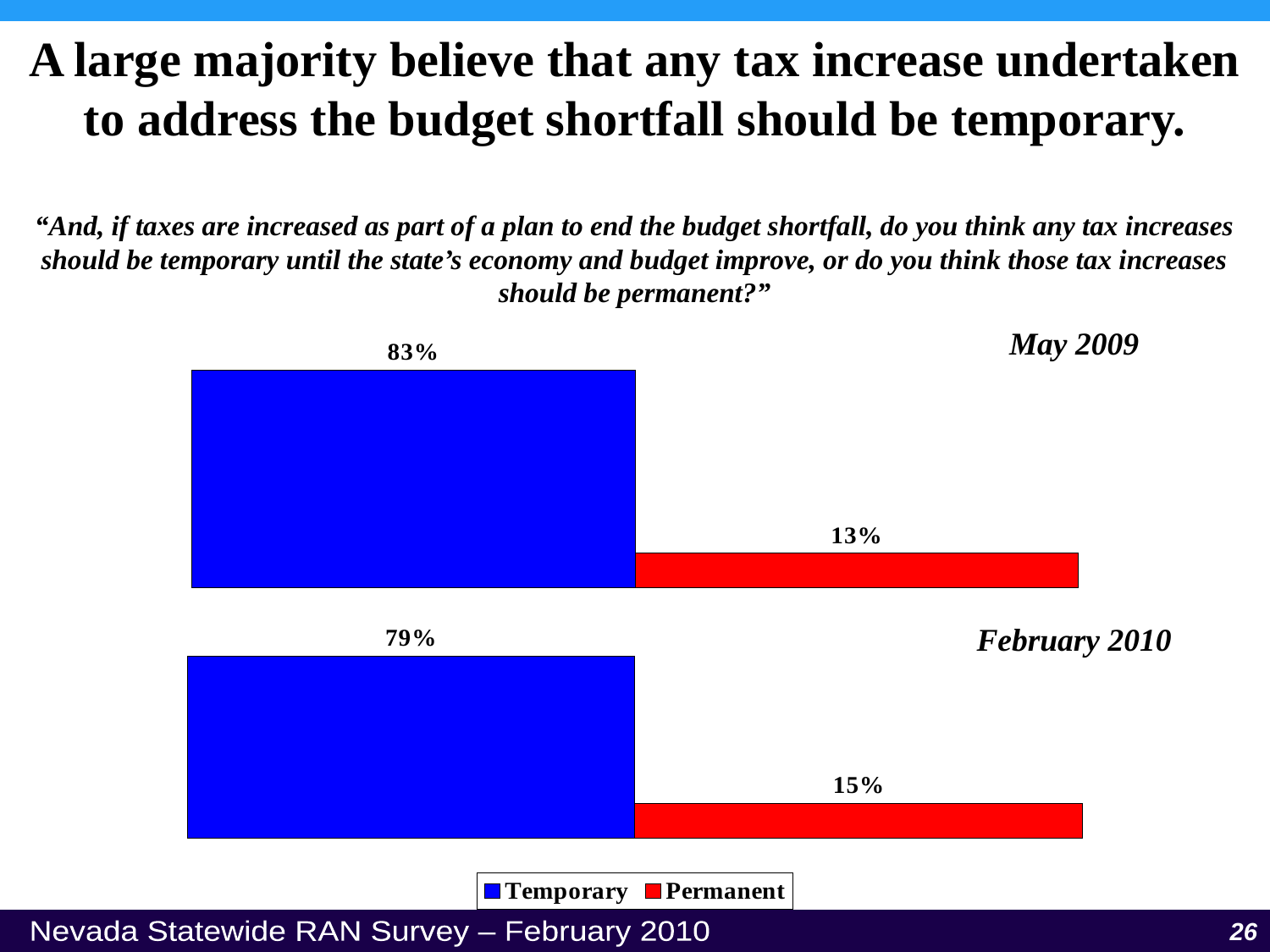
What is the difference between the Temporary and Permanent values in May 2009? 70 percentage points Which response had the lowest value in May 2009? Permanent What percentage said tax increases should be permanent in May 2009? 13% What percentage said tax increases should be temporary in May 2009? 83% What kind of chart is shown on the slide? Bar chart What percentage said tax increases should be permanent in February 2010? 15% Which colour represents the Permanent response in the chart? Red What percentage said tax increases should be temporary in February 2010? 79% How many series does the legend list? 2 Which is larger: the Permanent value in May 2009 or in February 2010? February 2010 Which response had the highest value in February 2010? Temporary By how much did the Temporary value change from May 2009 to February 2010? 4 percentage points